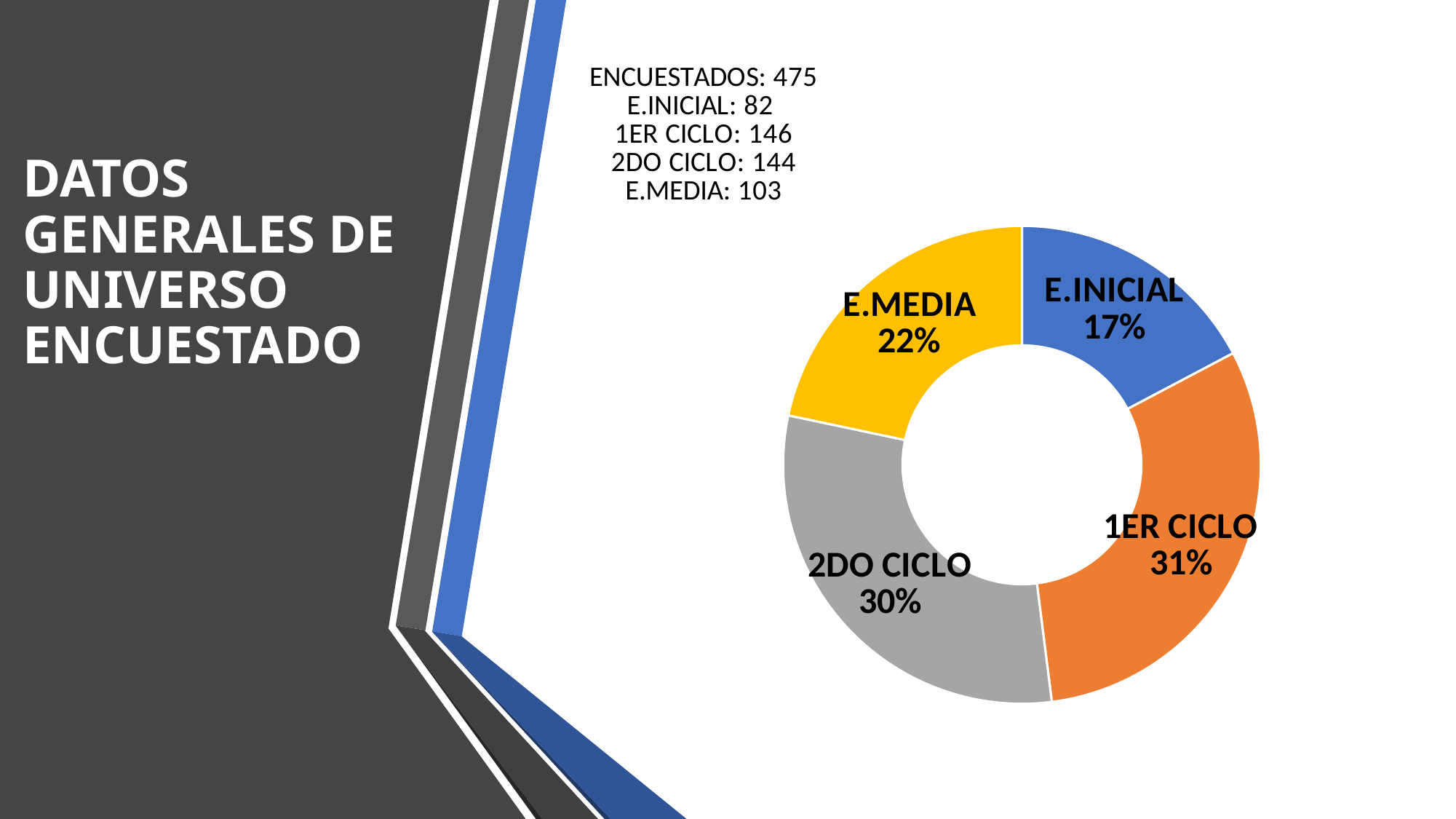
Which category has the largest share in the doughnut chart? 1ER CICLO What colour is the E.MEDIA segment in the doughnut chart? Yellow What is the difference in percentage points between the shares of E.MEDIA and E.INICIAL? 5 What percentage share does E.MEDIA have in the doughnut chart? 22% Which category has the smallest share in the doughnut chart? E.INICIAL Which has a larger share, E.MEDIA or E.INICIAL? E.MEDIA What percentage share does E.INICIAL have in the doughnut chart? 17% What percentage share does 2DO CICLO have in the doughnut chart? 30% What colour is the 2DO CICLO segment in the doughnut chart? Grey What percentage share does 1ER CICLO have in the doughnut chart? 31% How many categories are shown in the doughnut chart? 4 What kind of chart is shown on the slide? Doughnut chart